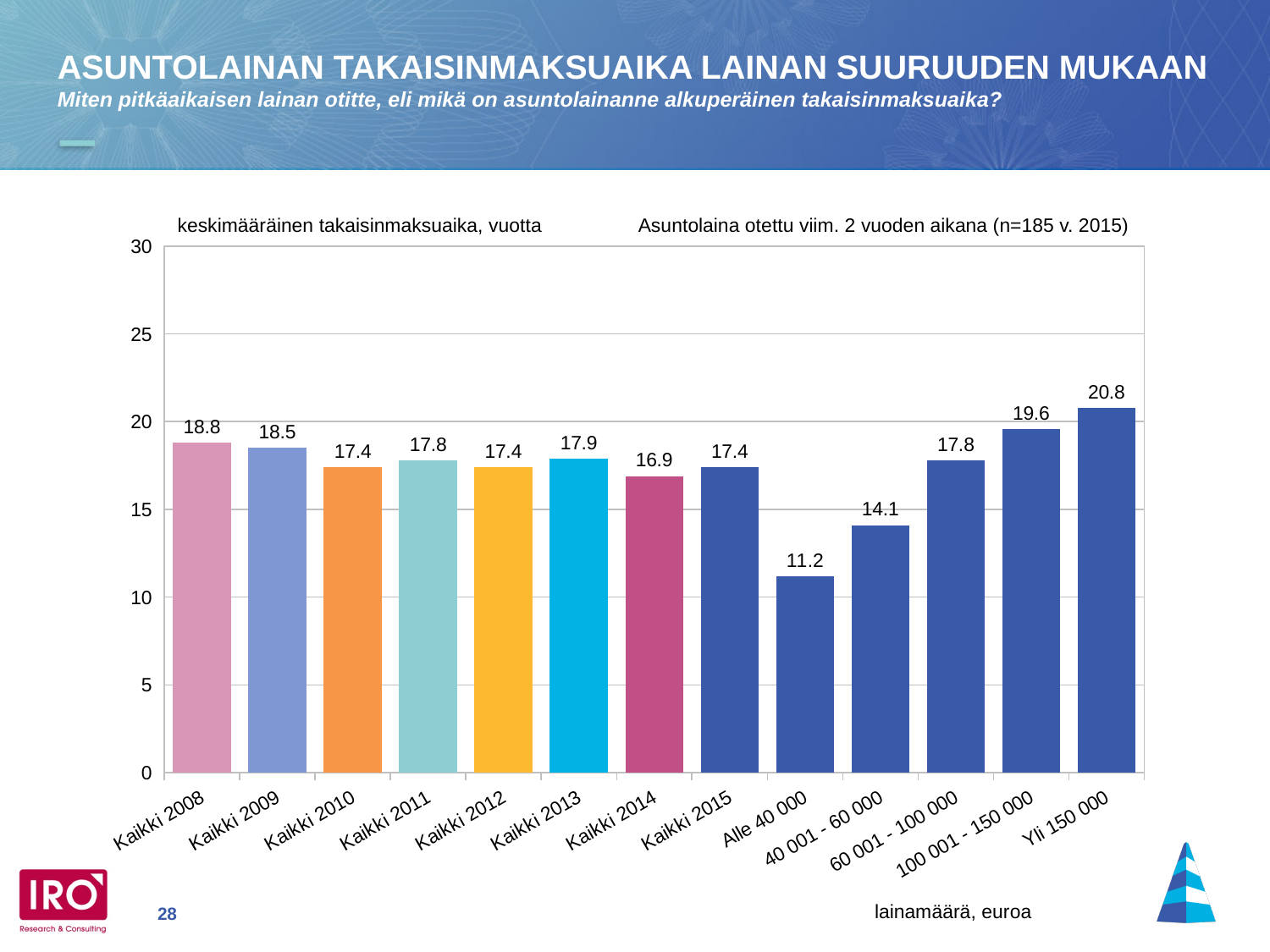
What is the difference between the values for Yli 150 000 and Alle 40 000? 9.6 What is the value for Alle 40 000? 11.2 What is the value for 100 001 - 150 000? 19.6 Which category has the highest value? Yli 150 000 What is the value for Yli 150 000? 20.8 Which category has the lowest value? Alle 40 000 What kind of chart is shown on the slide? bar chart Is the value for 40 001 - 60 000 greater or less than 15? less Which is larger, the value for Kaikki 2014 or the value for Kaikki 2015? Kaikki 2015 What is the label shown below the x axis of the chart? lainamäärä, euroa What is the value for Kaikki 2008? 18.8 How many categories are shown on the x axis? 13